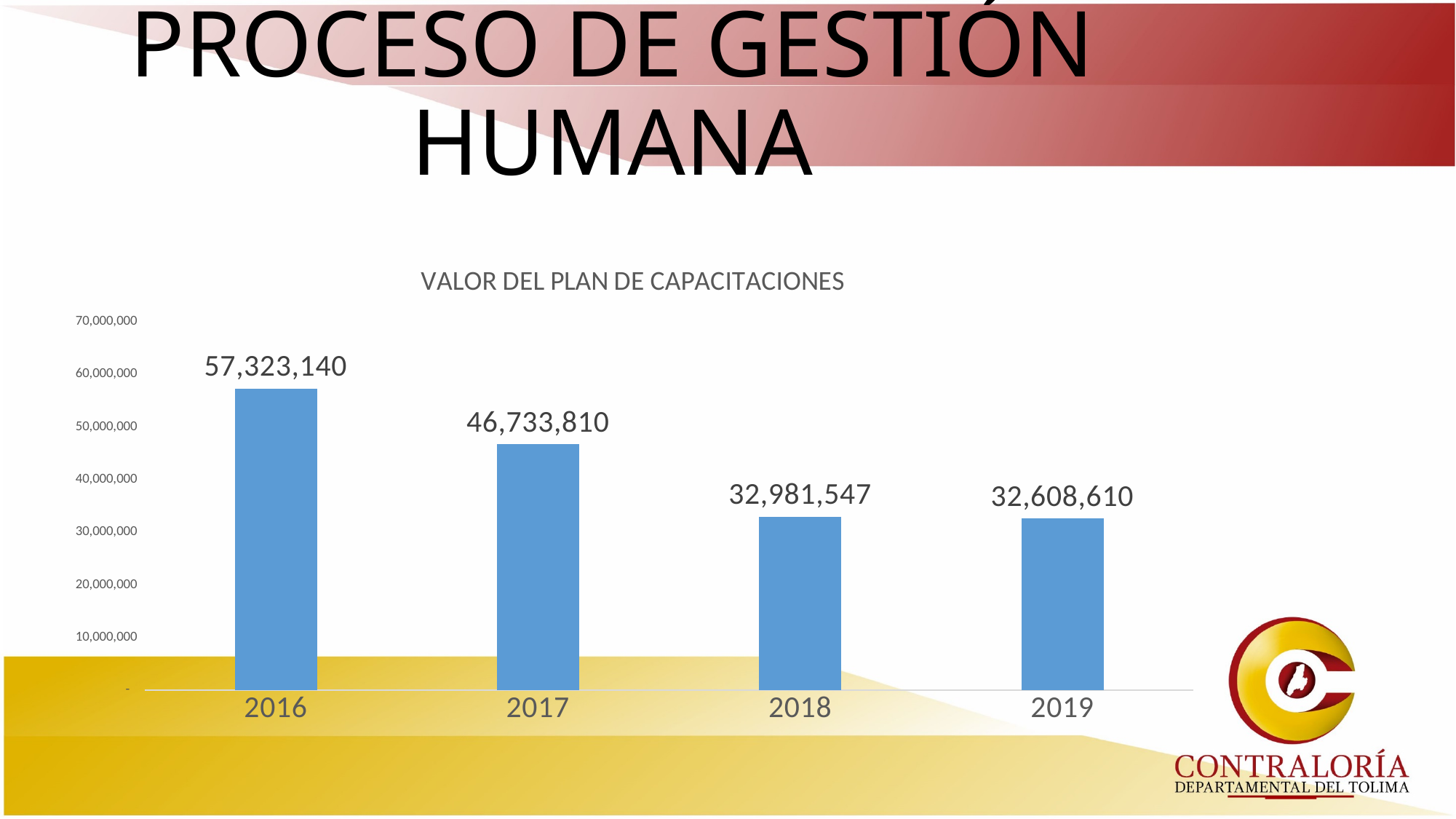
Do the values rise or fall from 2016 to 2019? Fall What is the value for 2018 in the chart? 32,981,547 Which year has the highest value in the chart? 2016 What is the value for 2019 in the chart? 32,608,610 What is the difference between the values for 2017 and 2018? 13,752,263 What is the value for 2016 in the chart? 57,323,140 What is the value for 2017 in the chart? 46,733,810 How many years are shown on the x axis of the chart? 4 What kind of chart is shown on the slide? Bar chart Which year has the lowest value in the chart? 2019 Which is larger, the value for 2016 or the value for 2018? 2016 What is the difference between the values for 2016 and 2017? 10,589,330